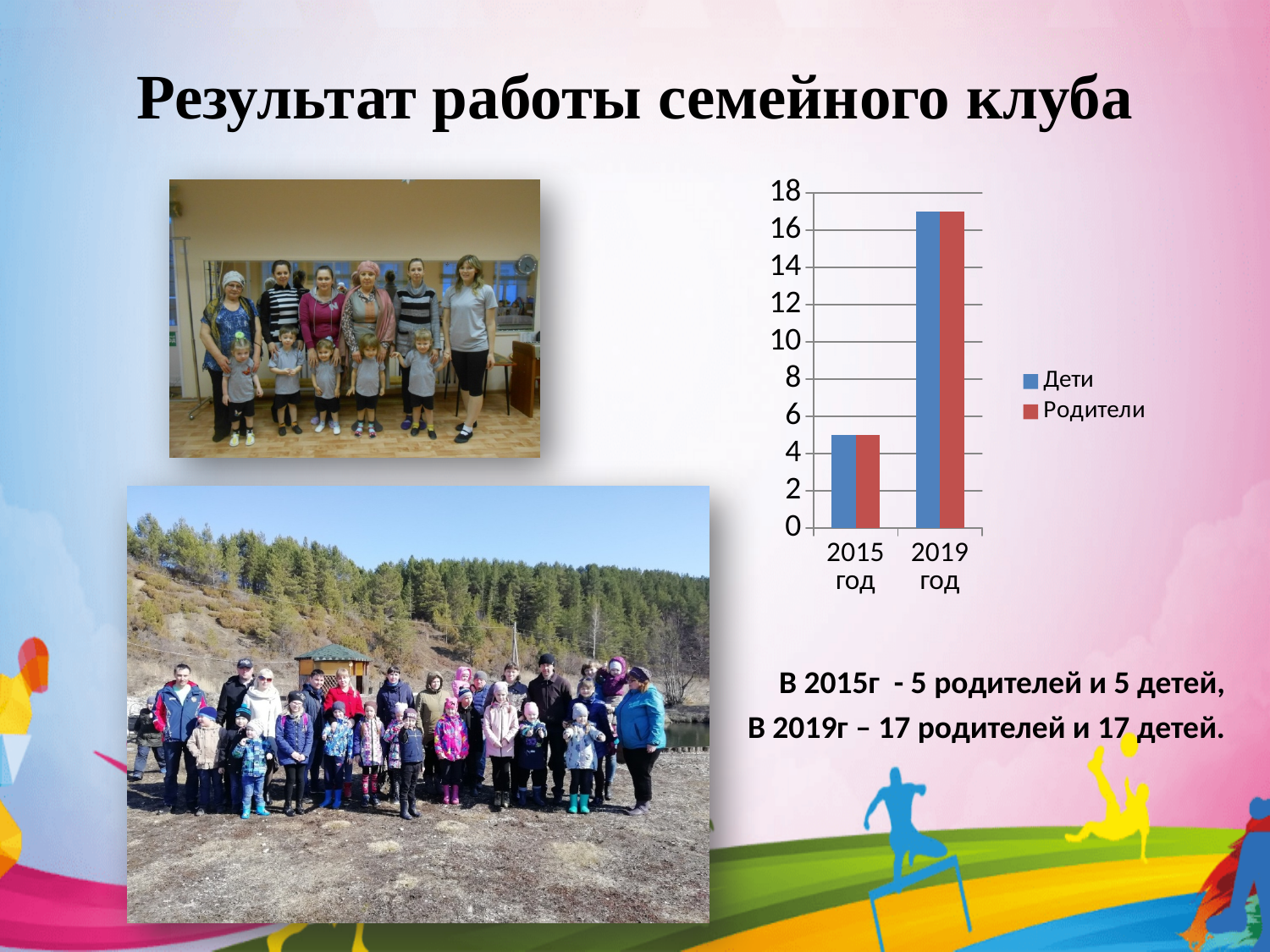
Which category has the lowest value for Родители? 2015 год What kind of chart is shown on the slide? bar chart How many series does the chart legend list? 2 Is the value for Дети in 2019 год greater or less than 16? greater What is the value for Родители in 2015 год? 5 What is the difference between the Родители value in 2019 год and in 2015 год? 12 How many categories are shown on the x axis of the chart? 2 What is the value for Дети in 2019 год? 17 Is the value for Родители in 2015 год greater or less than 6? less Which year has the higher value for Дети, 2015 год or 2019 год? 2019 год Do the values for Дети rise or fall from 2015 год to 2019 год? rise What colour are the bars for the Родители series? red